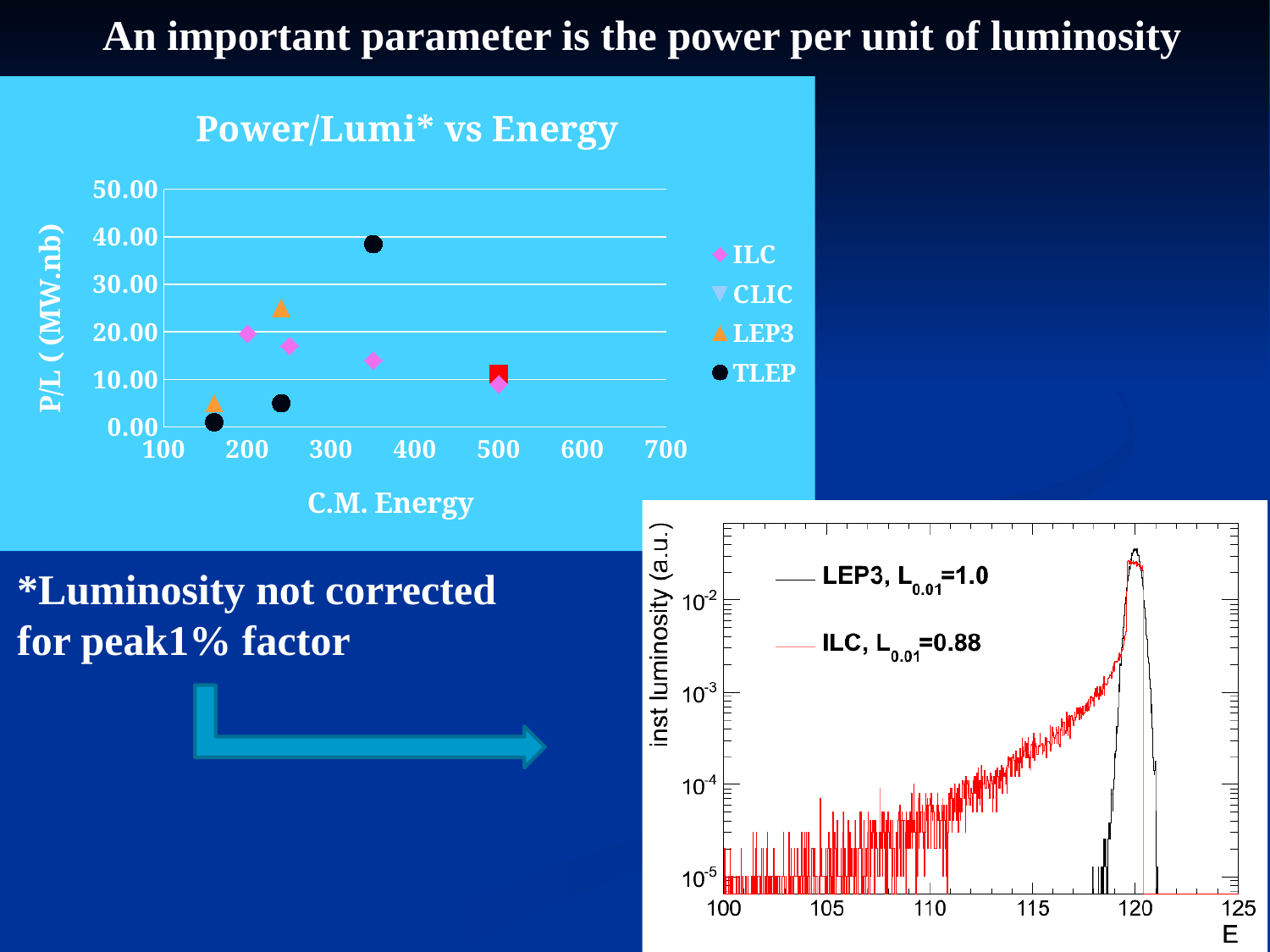
In the 'Power/Lumi* vs Energy' chart, how many series does the legend list? 4 In the 'Power/Lumi* vs Energy' chart, is the highest TLEP value greater or less than 30.00? greater In the bottom-right chart of inst luminosity vs E, which series is drawn in red? ILC In the 'Power/Lumi* vs Energy' chart, is the higher of the two LEP3 points greater or less than 20.00? greater In the 'Power/Lumi* vs Energy' chart, how many TLEP points are plotted? 3 In the 'Power/Lumi* vs Energy' chart, do the ILC values rise or fall as C.M. Energy increases? fall In the 'Power/Lumi* vs Energy' chart, how many ILC points are plotted? 4 In the 'Power/Lumi* vs Energy' chart, which series has the highest plotted point? TLEP In the 'Power/Lumi* vs Energy' chart, what is the x-axis label? C.M. Energy In the 'Power/Lumi* vs Energy' chart, what kind of chart is it? scatter chart In the bottom-right chart of inst luminosity vs E, how many series does the legend list? 2